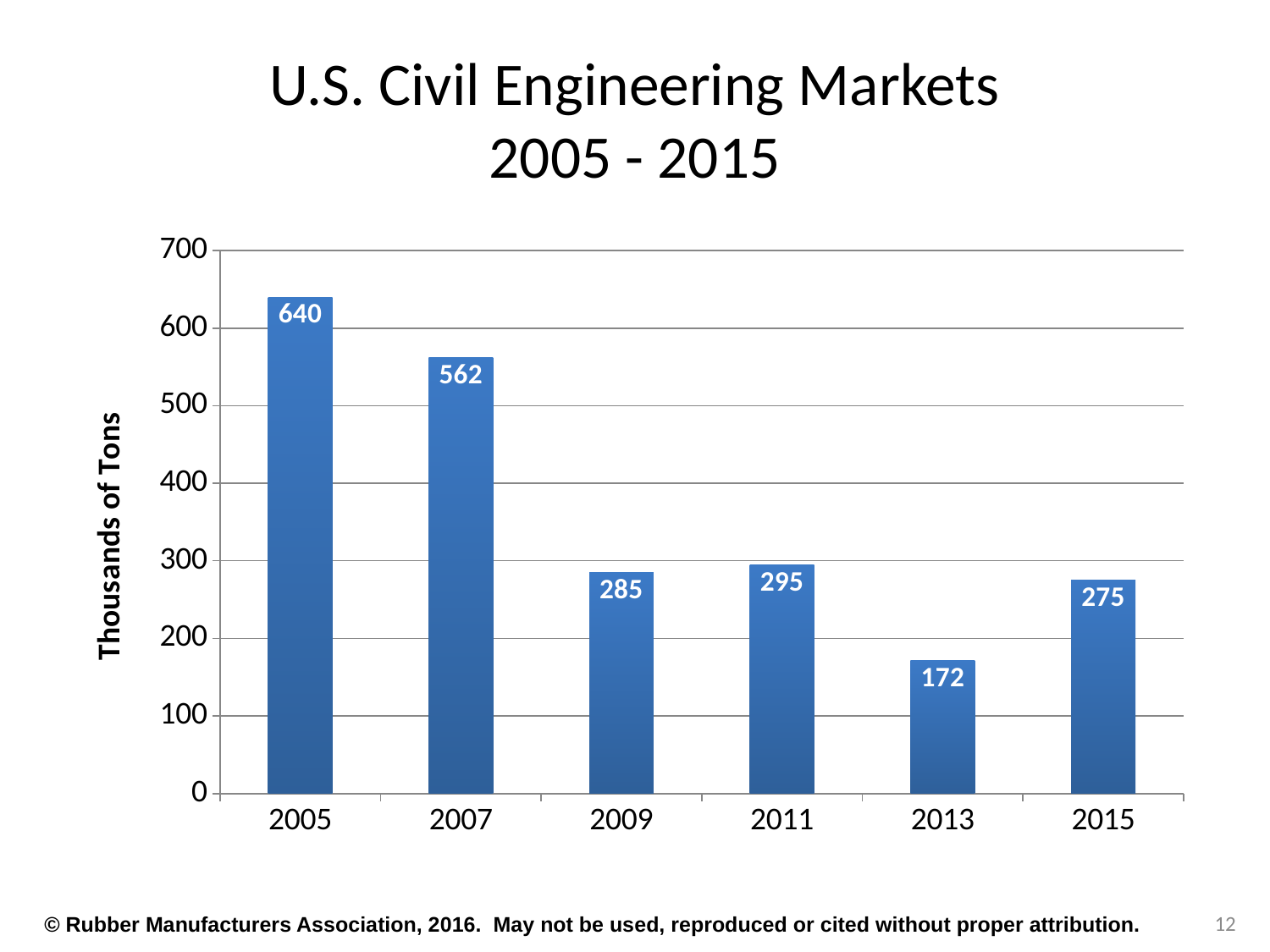
What is the difference between the values for 2005 and 2007? 78 What is the value for 2005? 640 Which year has the highest value? 2005 Which year has the lowest value? 2013 How many years are shown on the x axis? 6 What is the difference between the values for 2011 and 2013? 123 Is the value for 2007 greater or less than 500? greater What is the label on the vertical axis? Thousands of Tons What kind of chart is this? bar chart What is the value for 2015? 275 What is the value for 2013? 172 Which is larger, the value for 2009 or the value for 2015? 2009